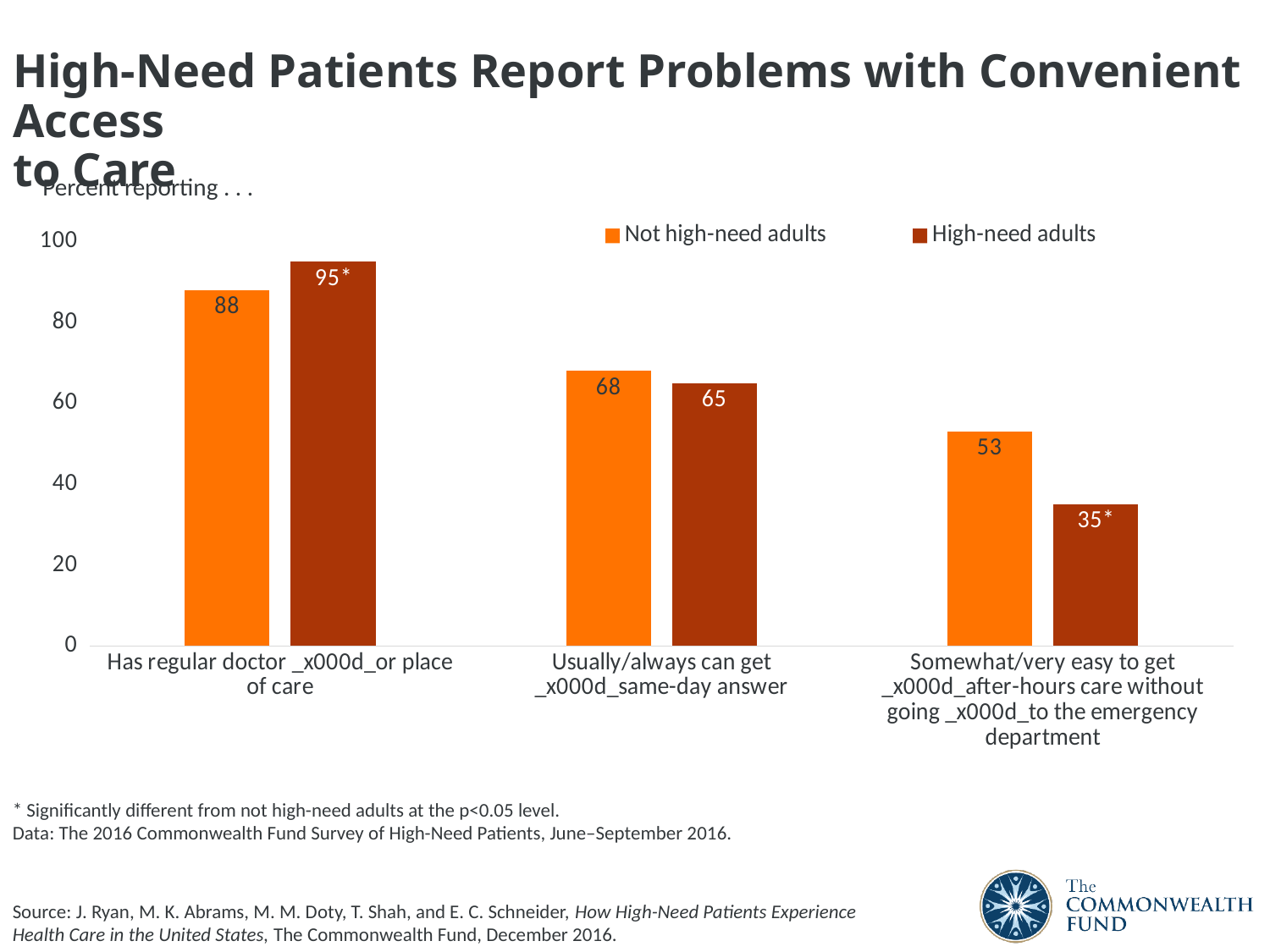
How many series does the legend list? 2 What is the difference between not high-need adults and high-need adults for getting after-hours care without going to the emergency department? 18 What percentage of high-need adults report they can usually/always get a same-day answer? 65 What percentage of not high-need adults report having a regular doctor or place of care? 88 How many categories are shown on the x axis? 3 Which series is shown in the darker red-brown colour? High-need adults Which category has the lowest value for high-need adults? Somewhat/very easy to get after-hours care without going to the emergency department What percentage of not high-need adults report it is somewhat/very easy to get after-hours care without going to the emergency department? 53 What kind of chart is shown on the slide? Bar chart What percentage of high-need adults report having a regular doctor or place of care? 95 Which category has the highest value for not high-need adults? Has regular doctor or place of care For usually/always can get same-day answer, which group has the higher value: not high-need adults or high-need adults? Not high-need adults